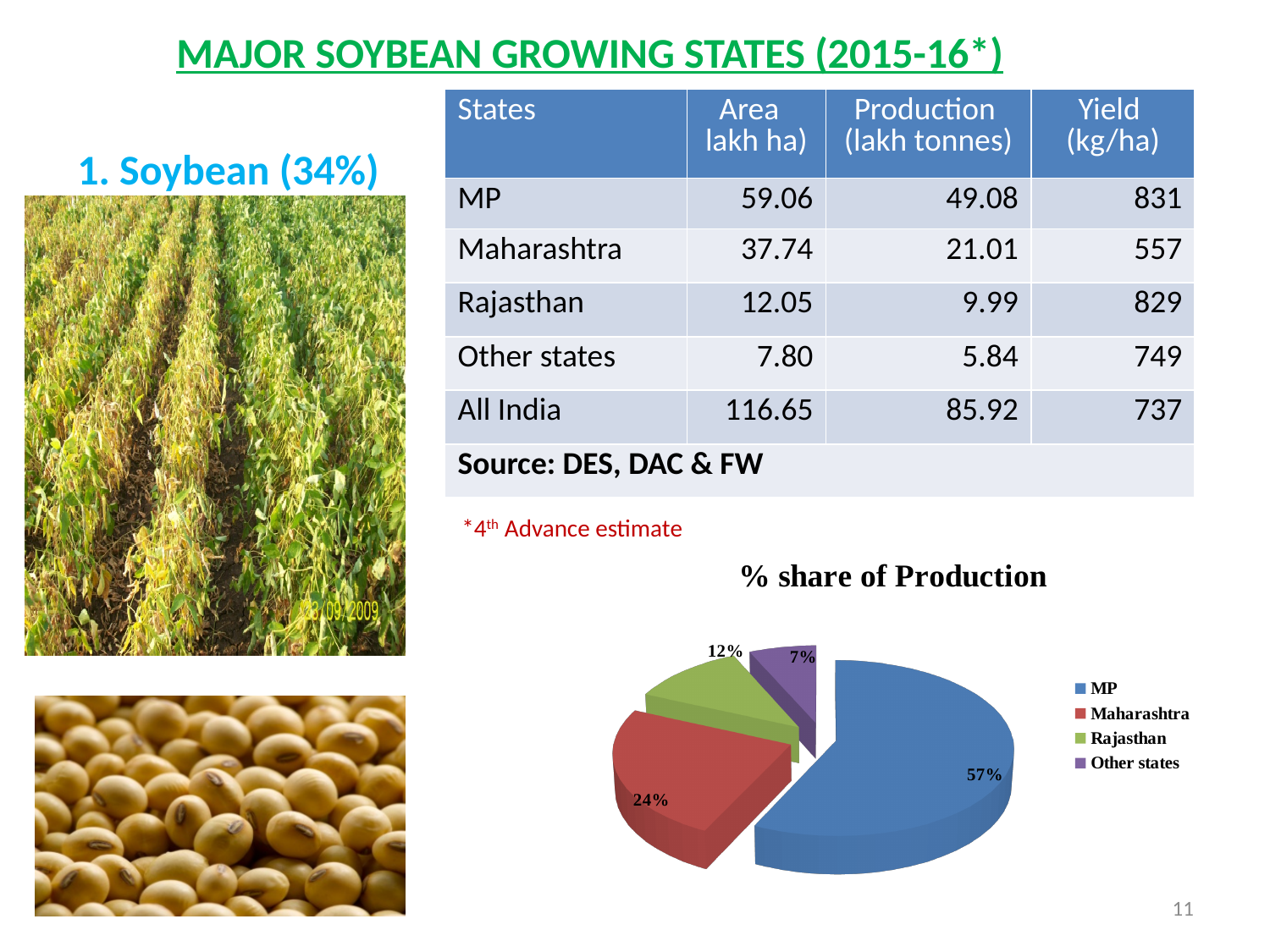
How many slices does the "% share of Production" pie chart have? 4 How many entries does the legend of the "% share of Production" pie chart list? 4 In the "% share of Production" pie chart, what share does Rajasthan have? 12% In the "% share of Production" pie chart, what share does Maharashtra have? 24% Which category has the smallest slice in the "% share of Production" pie chart? Other states In the "% share of Production" pie chart, what share do Other states have? 7% In the "% share of Production" pie chart, what colour is the Maharashtra slice? Red In the "% share of Production" pie chart, how many percentage points larger is MP's share than Maharashtra's? 33 What kind of chart is shown under the title "% share of Production"? Pie chart In the "% share of Production" pie chart, which is larger: Rajasthan's share or Other states' share? Rajasthan In the "% share of Production" pie chart, what share does MP have? 57% Which category has the largest slice in the "% share of Production" pie chart? MP